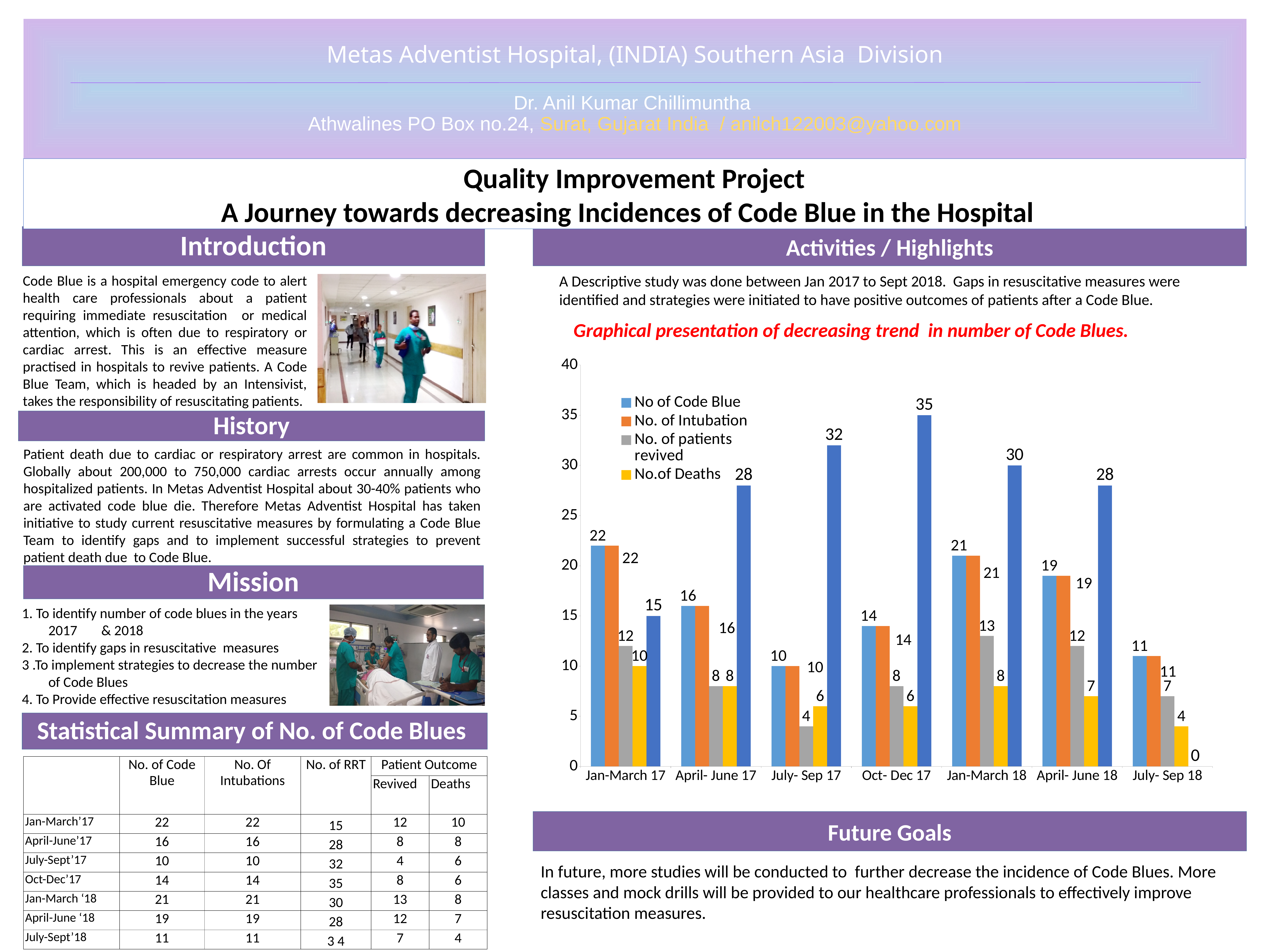
What is the value of 'No.of Deaths' for July- Sep 18? 4 How many quarterly categories are shown on the x axis of the chart? 7 Which is larger: 'No.of Deaths' in Jan-March 17 or 'No.of Deaths' in April- June 17? Jan-March 17 Which quarter has the highest value for 'No of Code Blue'? Jan-March 17 What colour represents 'No.of Deaths' in the chart's legend? Yellow Does the 'No of Code Blue' series generally rise or fall from Jan-March 17 to July- Sep 18? Fall What is the value of 'No of Code Blue' for Jan-March 17? 22 What is the value of 'No. of patients revived' for Jan-March 18? 13 What is the difference between 'No of Code Blue' in Jan-March 17 and in July- Sep 18? 11 What kind of chart is shown under 'Graphical presentation of decreasing trend in number of Code Blues'? Bar chart How many series does the chart's legend list? 4 Which quarter has the lowest value for 'No. of patients revived'? July- Sep 17